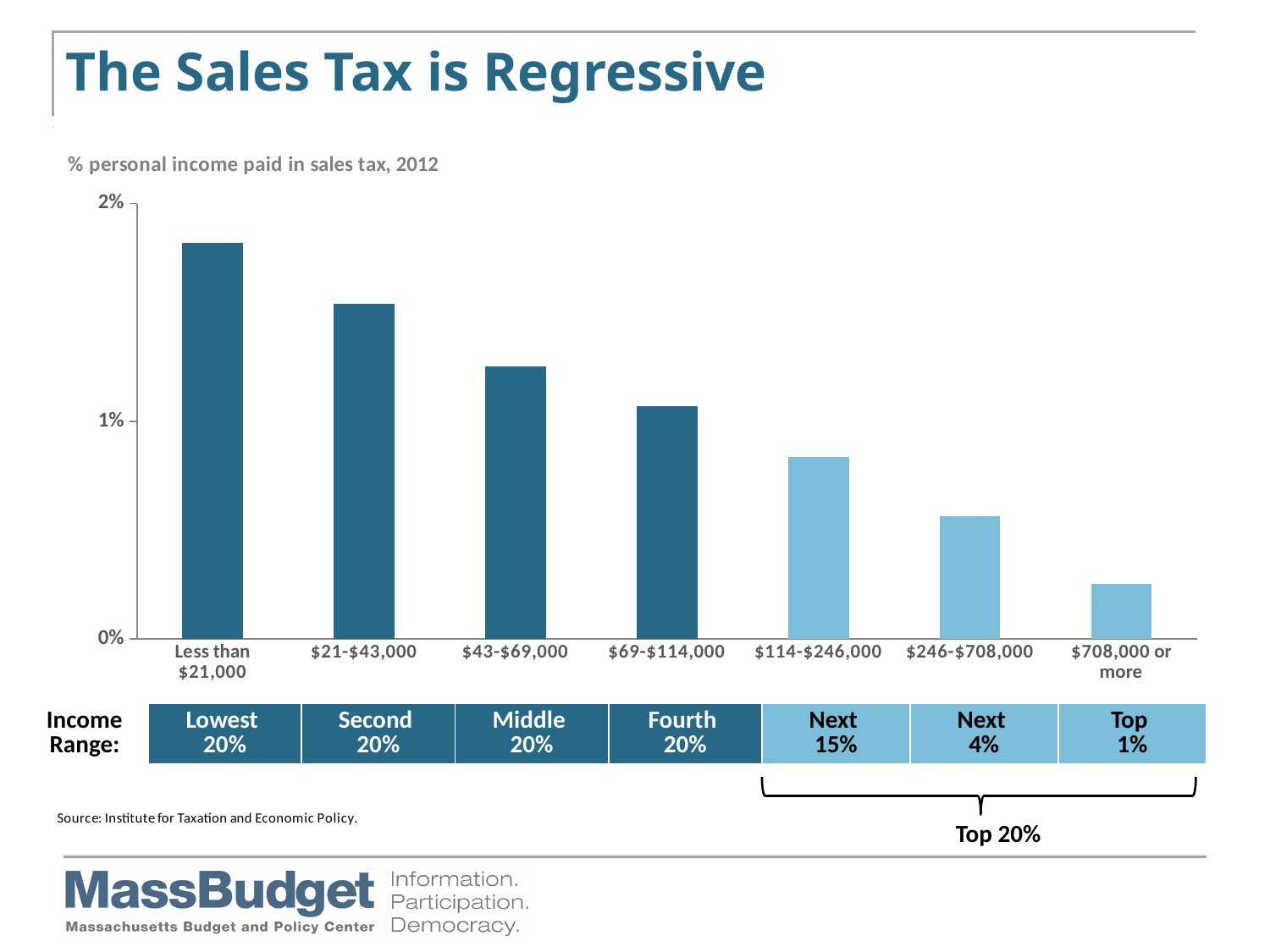
Which income category pays the lowest share of personal income in sales tax? $708,000 or more Do the values rise or fall as income increases along the x axis? fall What is the title of the slide? The Sales Tax is Regressive What does the chart subtitle say is being measured? % personal income paid in sales tax, 2012 Which income category pays the highest share of personal income in sales tax? Less than $21,000 Is the value for the $708,000 or more category greater or less than 1%? less How many income categories are plotted in the chart? 7 Which pays a larger share of income in sales tax: the $43-$69,000 category or the $246-$708,000 category? $43-$69,000 Is the value for the $21-$43,000 category greater or less than 1%? greater What kind of chart is shown on the slide? bar chart Is the value for the $114-$246,000 category greater or less than 1%? less